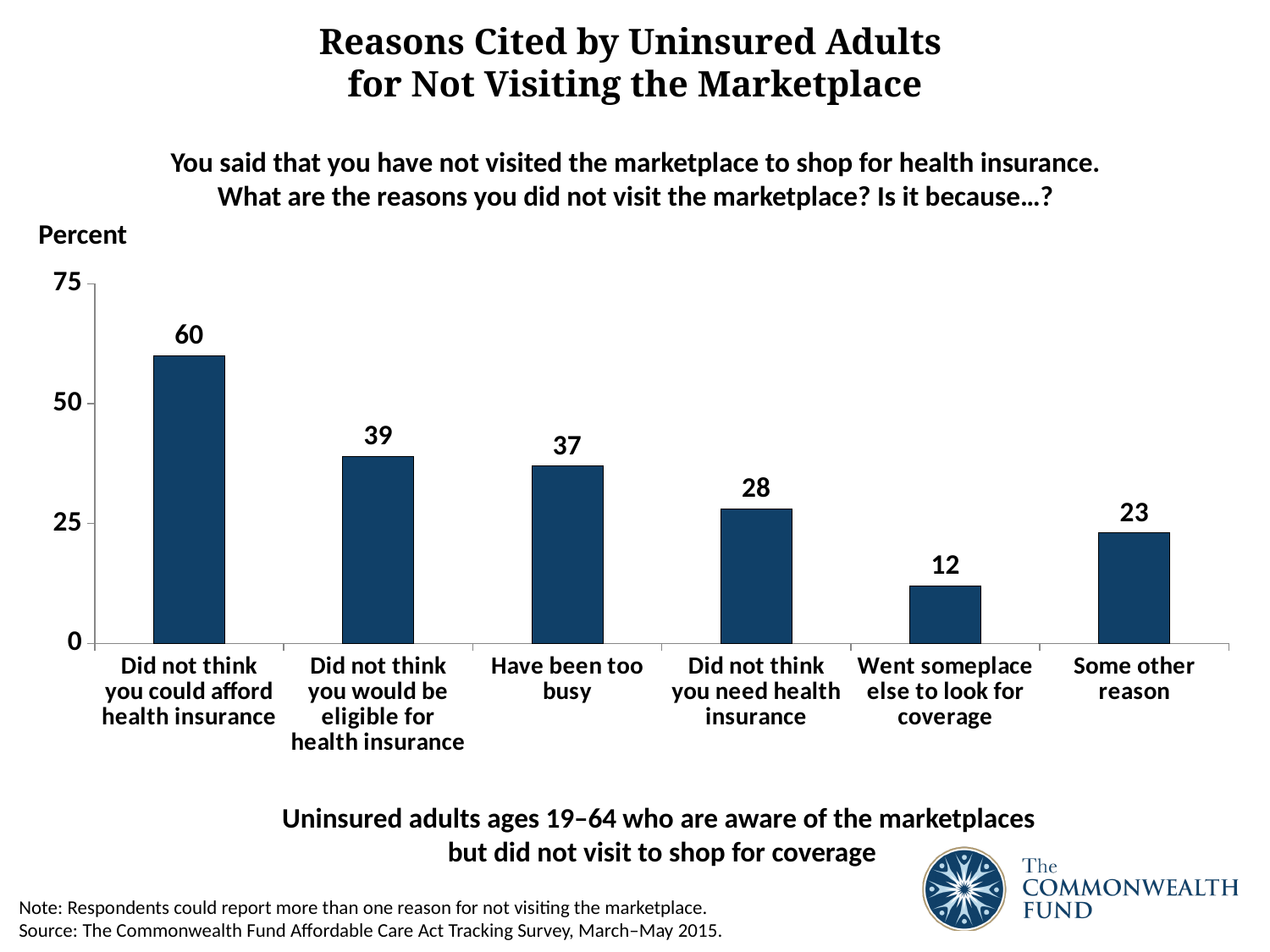
What percent cited "Went someplace else to look for coverage"? 12 Which is larger: "Did not think you need health insurance" or "Some other reason"? Did not think you need health insurance Which reason has the highest value? Did not think you could afford health insurance What percent of uninsured adults said they did not think they could afford health insurance? 60 What is the label on the vertical axis? Percent How many reasons are shown on the chart? 6 What kind of chart is shown on the slide? Bar chart What is the value for "Have been too busy"? 37 Which reason has the lowest value? Went someplace else to look for coverage What is the difference between "Did not think you could afford health insurance" and "Did not think you would be eligible for health insurance"? 21 Is the value for "Did not think you would be eligible for health insurance" greater or less than 25? greater What is the title of the chart? Reasons Cited by Uninsured Adults for Not Visiting the Marketplace